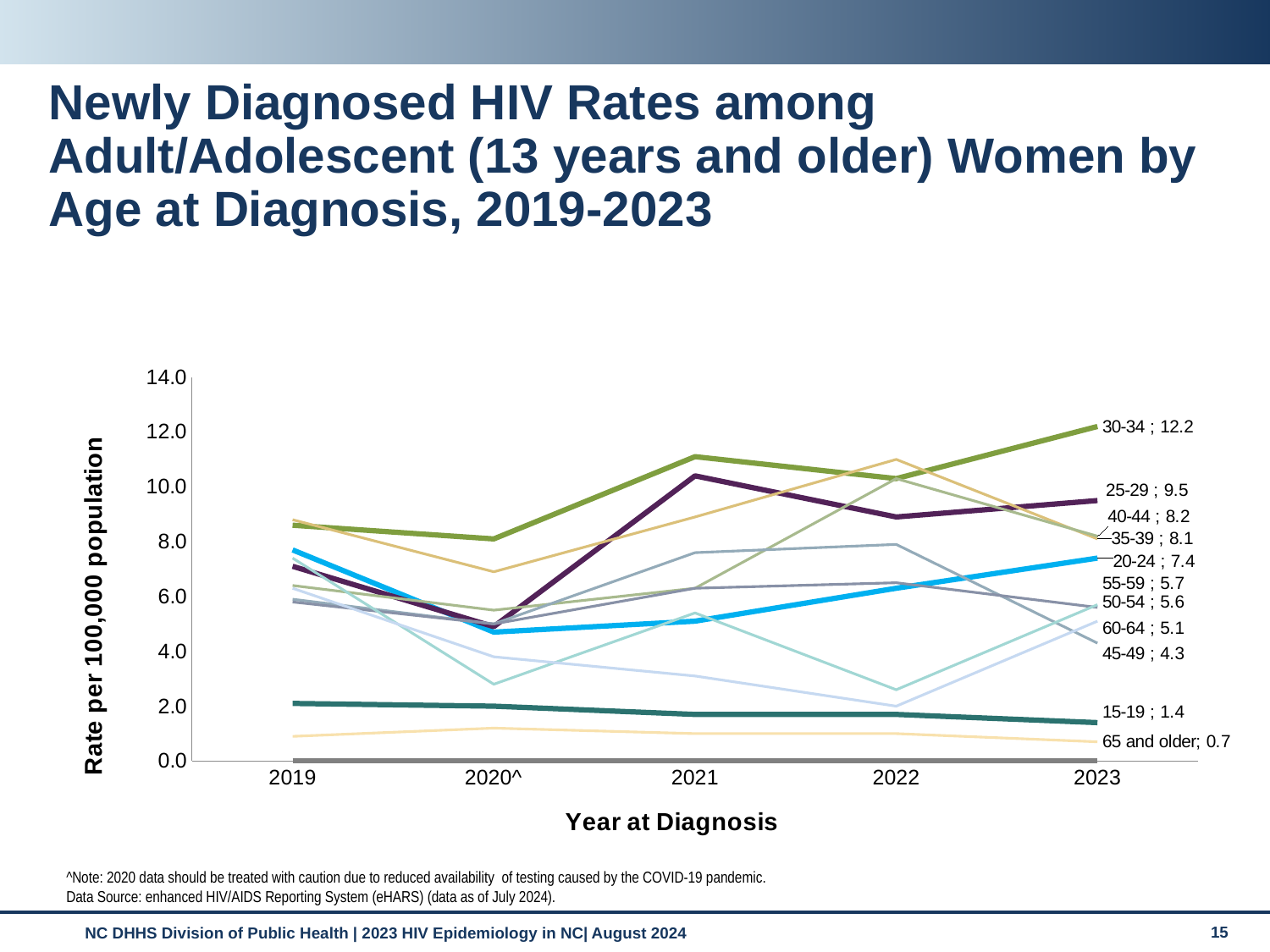
Which age group has the lowest rate in 2023? 65 and older What is the 2023 rate for the 30-34 age group? 12.2 What is the 2023 rate for the 65 and older age group? 0.7 How many years are shown on the x axis? 5 What is the difference between the 2023 rates for the 30-34 and 25-29 age groups? 2.7 Which age group has the highest rate in 2023? 30-34 What is the 2023 rate for the 20-24 age group? 7.4 In 2023, which age group has the larger rate, 45-49 or 60-64? 60-64 Is the value for the 30-34 age group in 2021 greater or less than 10.0? greater What kind of chart is shown on the slide? Line chart What is the title of the y axis? Rate per 100,000 population Is the value for the 15-19 age group in 2019 greater or less than 4.0? less